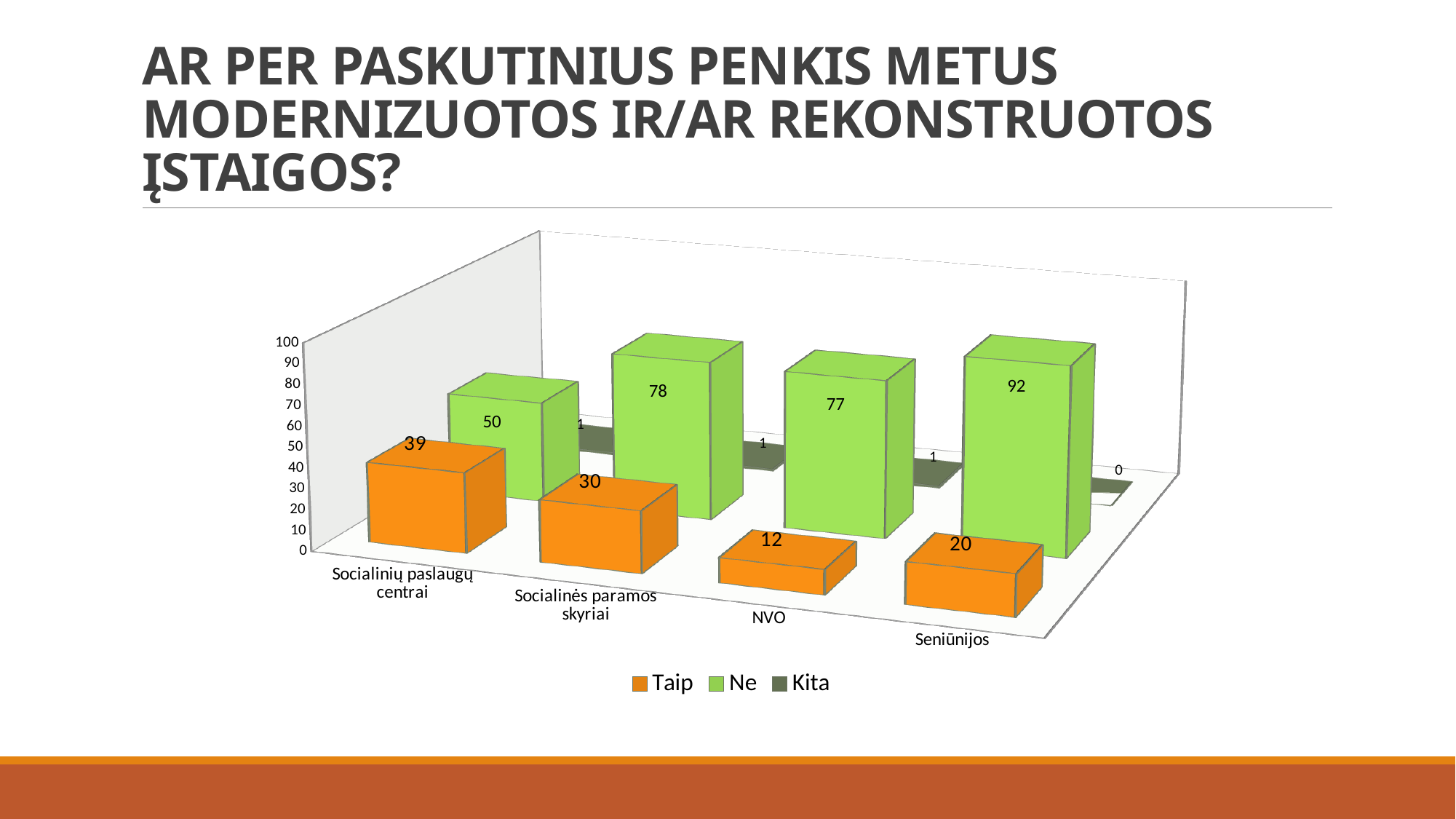
What is the value of "Taip" for Socialinių paslaugų centrai? 39 Which category has the lowest "Taip" value? NVO How many categories are shown on the x axis? 4 What is the difference between the "Ne" and "Taip" values for Socialinės paramos skyriai? 48 What is the value of "Taip" for NVO? 12 What kind of chart is shown on the slide? Bar chart What is the value of "Kita" for Seniūnijos? 0 How many series does the legend list? 3 What is the value of "Ne" for Seniūnijos? 92 Which category has the highest "Ne" value? Seniūnijos Which is larger: the "Taip" value for Socialinių paslaugų centrai or the "Taip" value for Seniūnijos? Socialinių paslaugų centrai Which colour represents the "Ne" series in the legend? Green